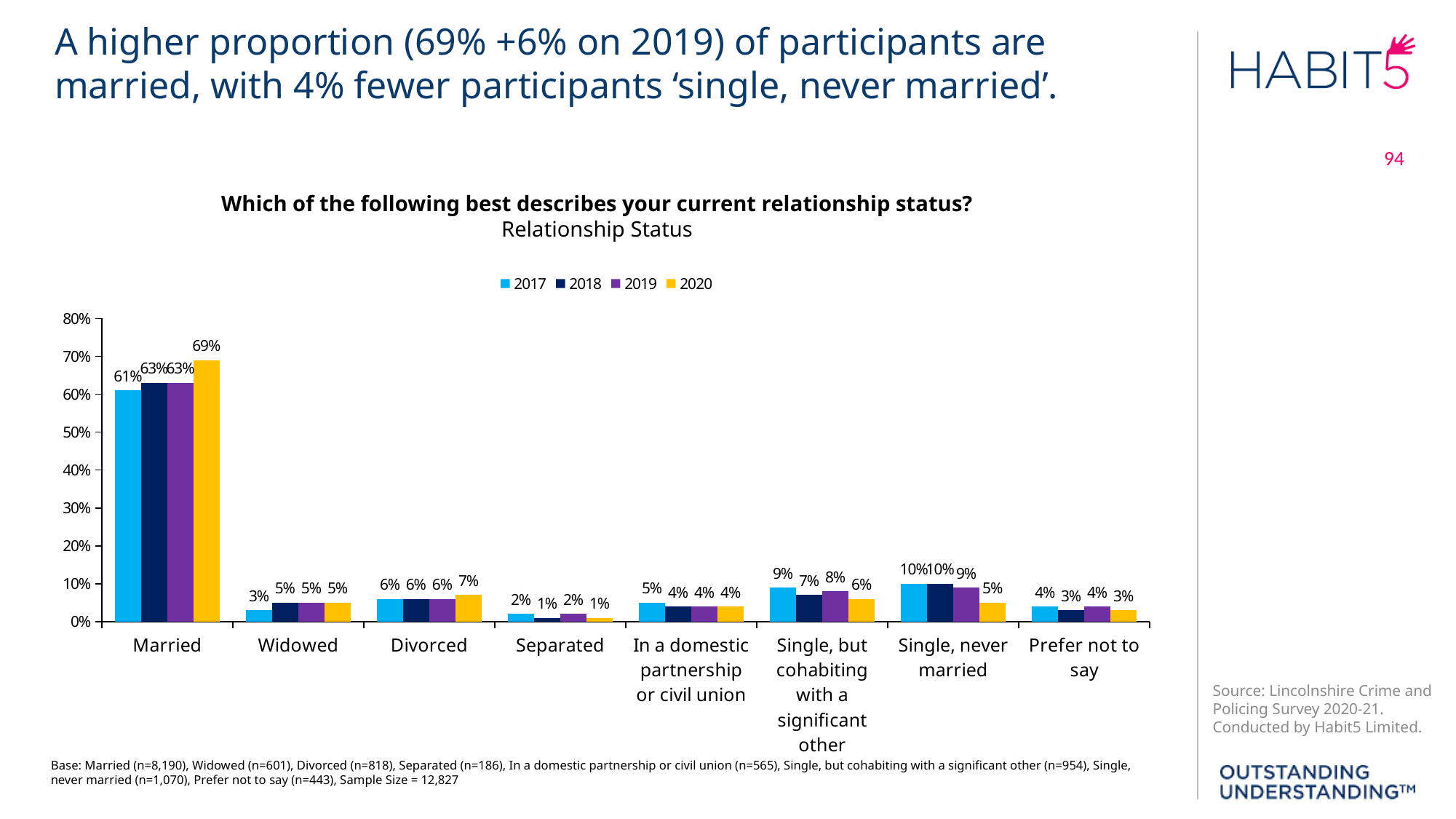
Which is larger for 'Single, but cohabiting with a significant other': the 2017 value or the 2020 value? 2017 Which relationship status has the highest value in 2020? Married How many series does the legend list? 4 How many relationship status categories are shown on the x axis? 8 What percentage of participants were married in 2020? 69% Which year is represented by the yellow bars in the legend? 2020 What is the difference between the 2019 and 2020 values for 'Single, never married'? 4% Which relationship status has the lowest value in 2020? Separated What is the value for Divorced in 2020? 7% What is the difference between the 2020 and 2019 values for Married? 6% What kind of chart is shown on the slide? Bar chart What percentage of participants were 'Single, never married' in 2017? 10%